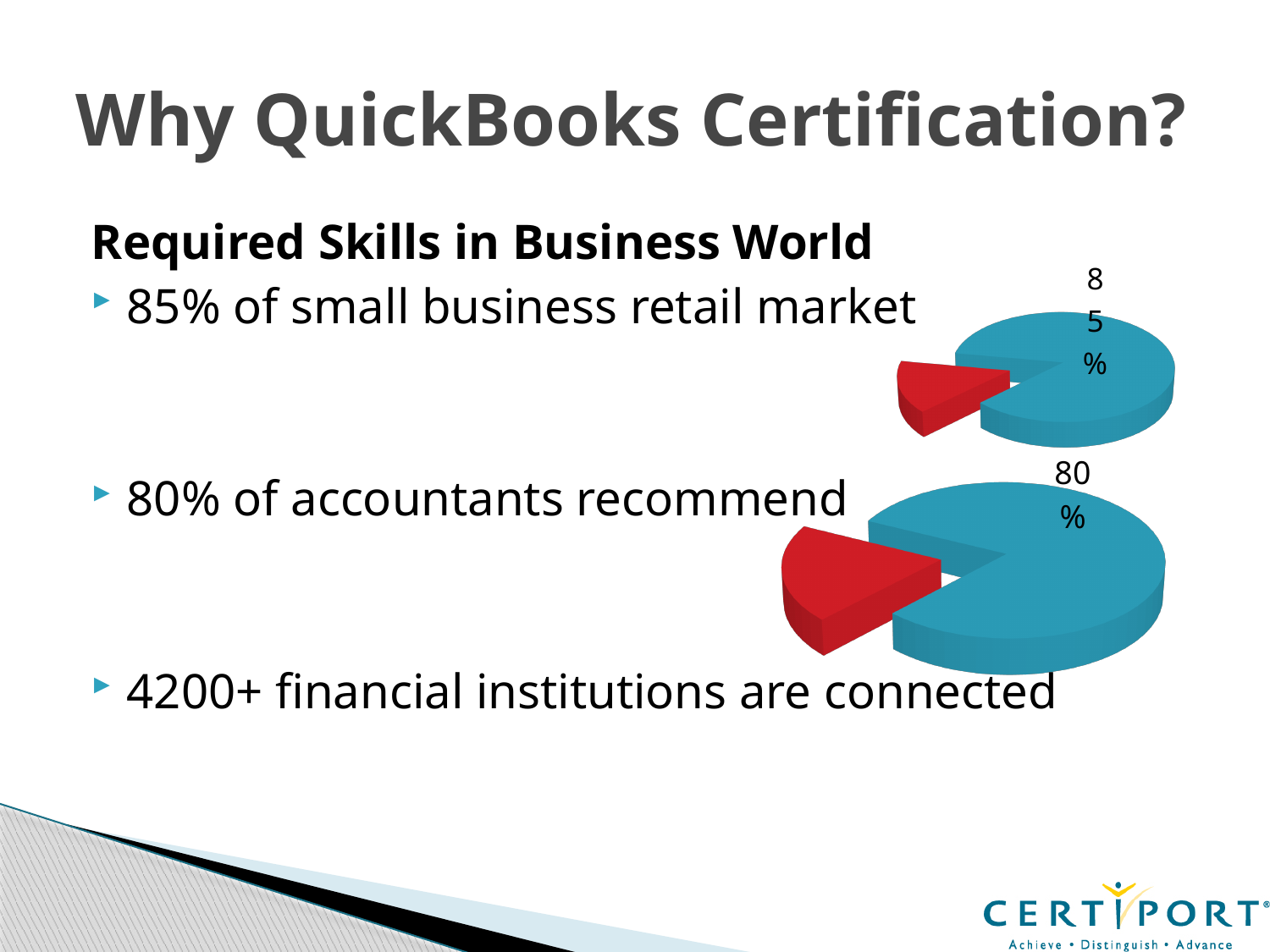
In the upper pie chart, which slice is larger, the blue one or the red one? the blue one In the lower pie chart, which slice is larger, the blue one or the red one? the blue one What colour is the smaller, pulled-out slice in both pie charts? red In the lower pie chart, what value is printed on the blue slice? 80% What kind of chart is the upper chart on the right of the slide? pie chart Which pie chart has the larger labelled blue slice, the upper one or the lower one? the upper one What share of the lower pie chart does the blue slice represent? 80% In the upper pie chart, what value is printed on the blue slice? 85% What kind of chart is the lower chart on the right of the slide? pie chart How many slices does the upper pie chart have? 2 What share of the upper pie chart does the blue slice represent? 85% How many slices does the lower pie chart have? 2